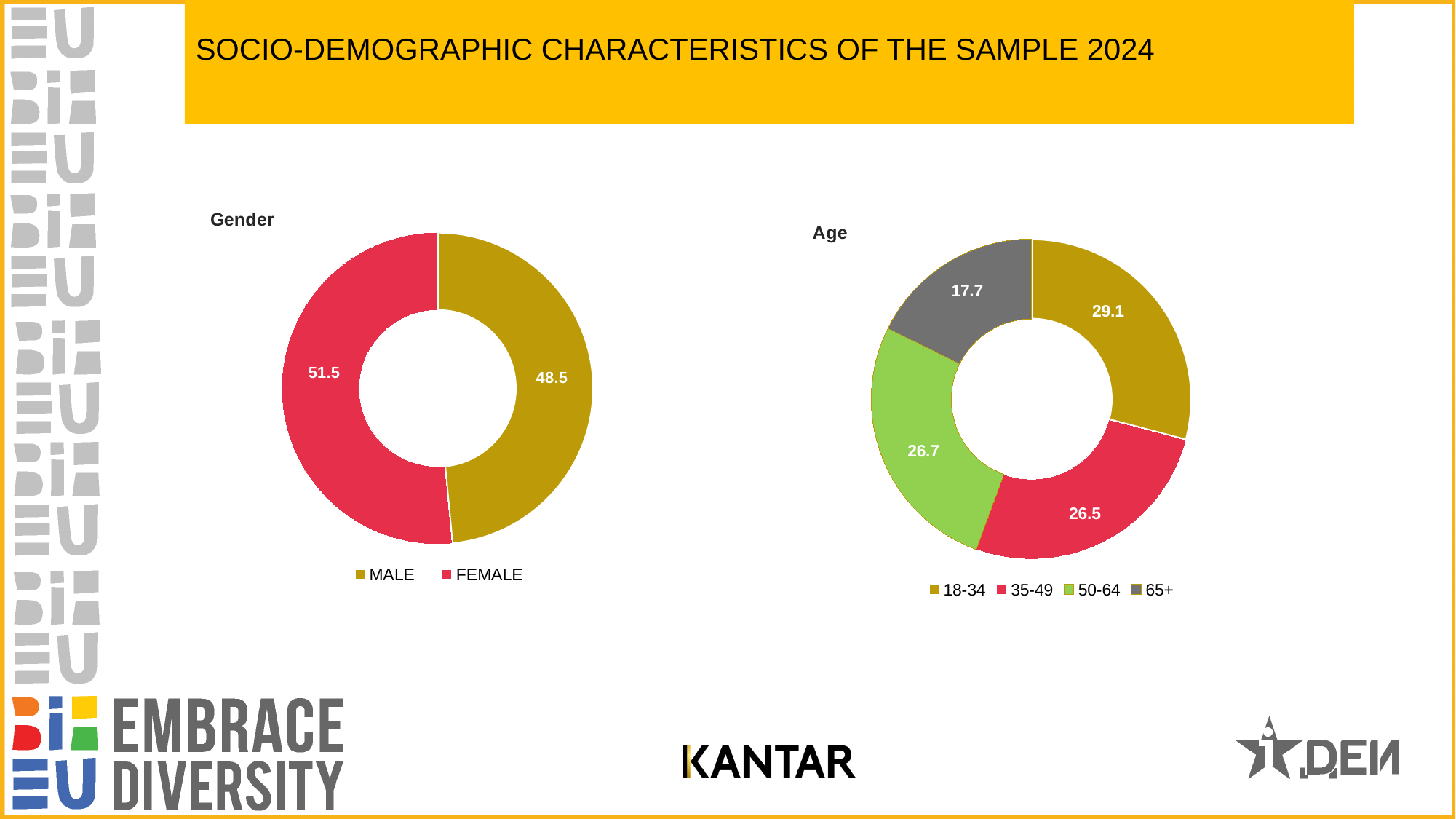
In the Gender chart, what is the difference between the FEMALE and MALE values? 3.0 In the Age chart, which age group has the highest value? 18-34 In the Gender chart, which category has the larger value, MALE or FEMALE? FEMALE How many age groups are shown in the Age chart? 4 In the Age chart, what is the value for the 65+ group? 17.7 In the Age chart, what is the value for the 18-34 group? 29.1 In the Age chart, what is the difference between the 18-34 and 65+ values? 11.4 In the Gender chart, what is the value for FEMALE? 51.5 In the Age chart, which age group has the lowest value? 65+ How many series does the legend of the Age chart list? 4 In the Gender chart, what is the value for MALE? 48.5 What kind of chart is the Gender chart? Doughnut chart